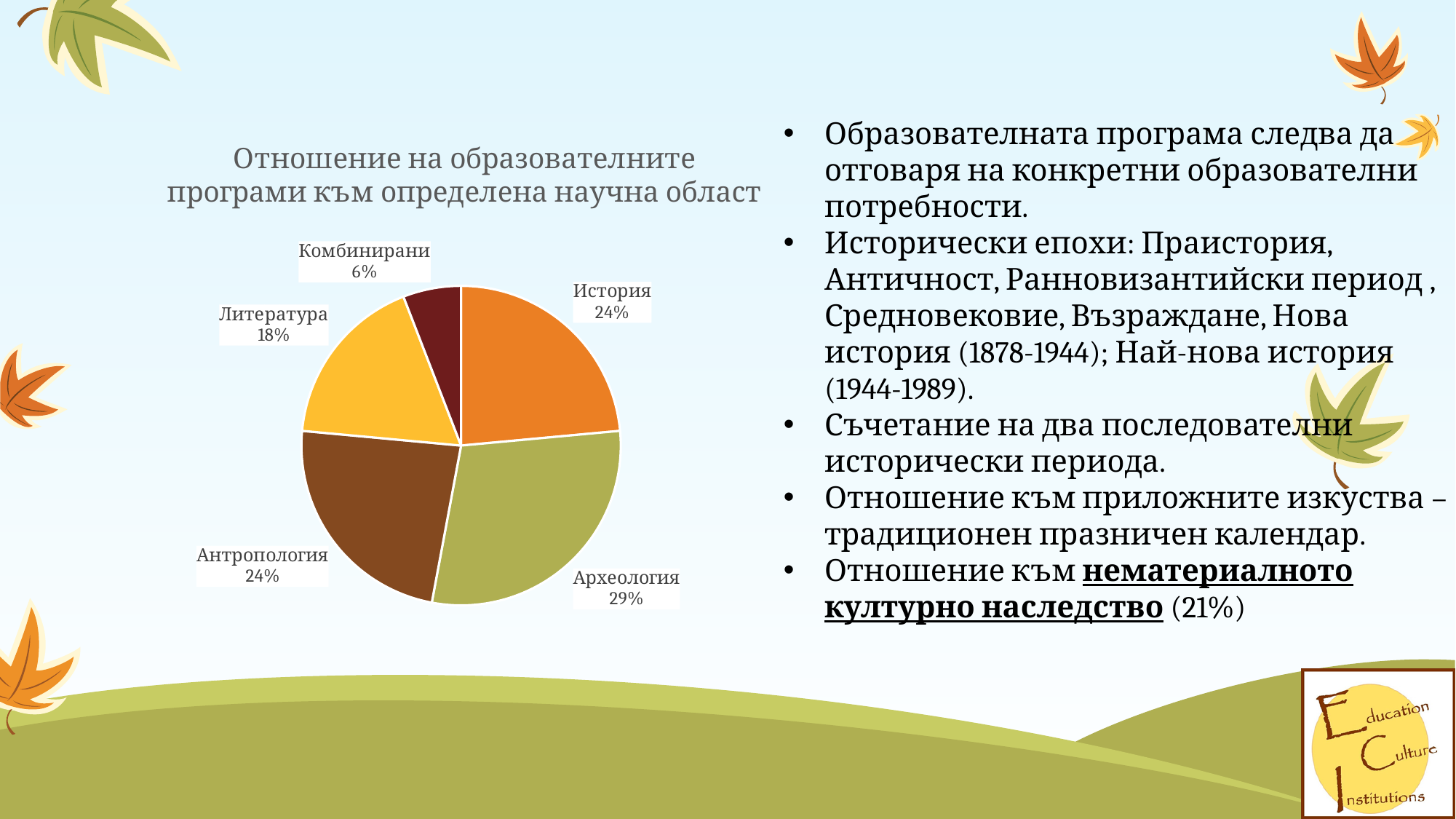
What colour is the Археология slice? olive green What is the difference between the shares of Археология and Литература? 11% Which is larger, the share for Литература or the share for Антропология? Антропология Which category has the smallest share of the pie? Комбинирани What is the value for Комбинирани? 6% How many slices does the pie chart have? 5 What type of chart is shown on the slide? pie chart What is the title of the chart? Отношение на образователните програми към определена научна област What is the value for История? 24% What share of the pie does Археология have? 29% Which category has the largest share of the pie? Археология What is the value for Литература? 18%